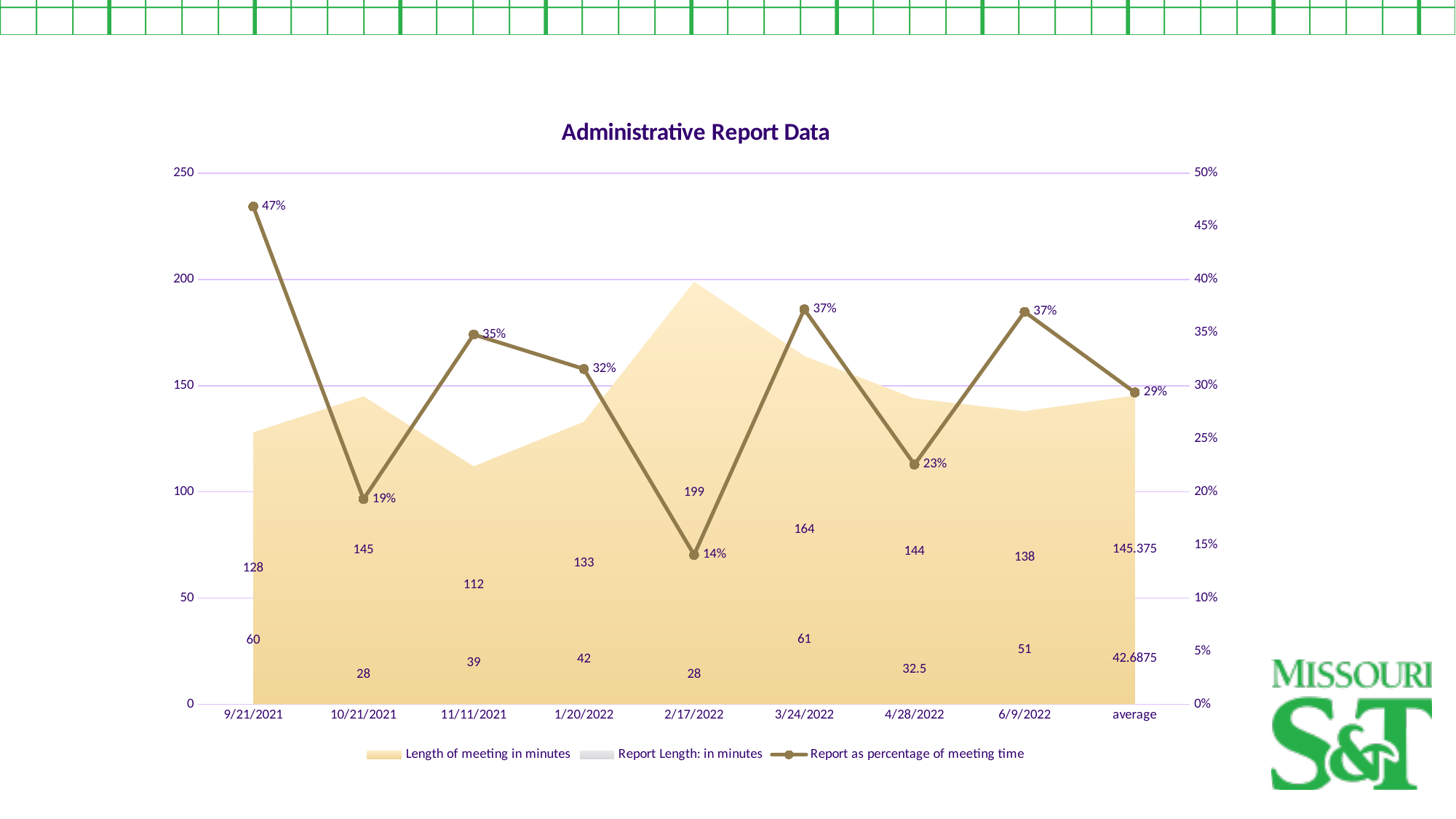
Which is larger, the report length in minutes for 9/21/2021 or for 6/9/2022? 9/21/2021 Which date has the lowest report as percentage of meeting time? 2/17/2022 What is the difference in length of meeting in minutes between 2/17/2022 and 11/11/2021? 87 What is the report length in minutes for 3/24/2022? 61 What is the average length of meeting in minutes? 145.375 What is the report as percentage of meeting time for 9/21/2021? 47% Which date has the highest length of meeting in minutes? 2/17/2022 What is the title of the chart? Administrative Report Data How many series does the legend list? 3 How many categories are shown on the x axis? 9 Is the length of meeting in minutes for 10/21/2021 greater or less than 100? greater What is the length of meeting in minutes for 2/17/2022? 199